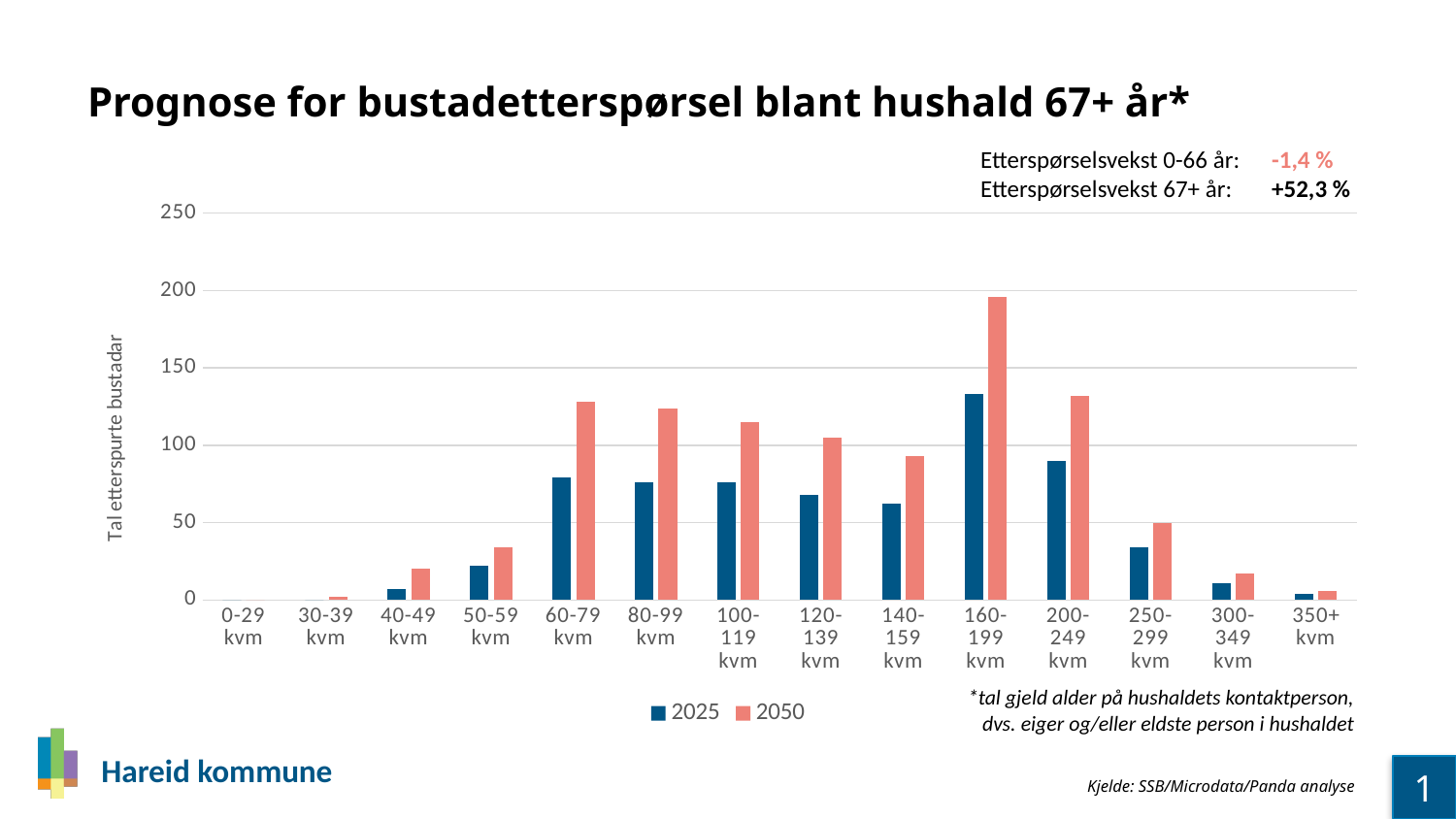
For 160-199 kvm, which series has the larger value, 2025 or 2050? 2050 Is the 2050 value for 60-79 kvm greater or less than 100? greater Which size category has the highest value for the 2025 series? 160-199 kvm Which size category has the highest value for the 2050 series? 160-199 kvm Is the 2025 value for 160-199 kvm greater or less than 100? greater What demand growth (Etterspørselsvekst) is stated for households 67+ år? +52,3 % Is the 2050 value for 160-199 kvm greater or less than 150? greater What is the label on the y axis? Tal etterspurte bustadar How many series does the legend list? 2 What kind of chart is shown on the slide? bar chart How many size categories are shown on the x axis? 14